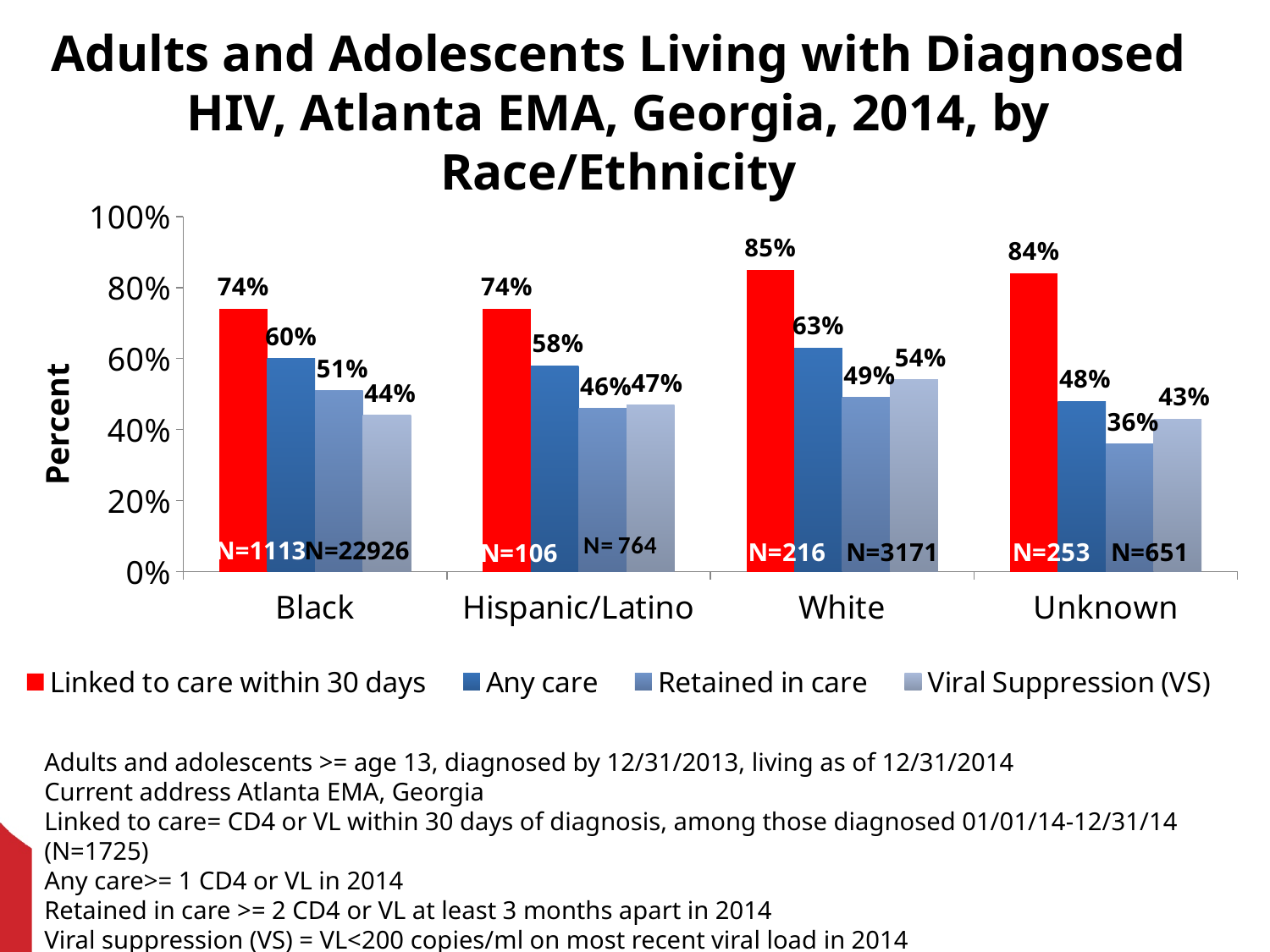
What is the value for Retained in care for Hispanic/Latino? 46% How many series does the legend list? 4 What is the value for Any care for Black? 60% What is the value for Viral Suppression (VS) for Unknown? 43% What is the value for Linked to care within 30 days for White? 85% Which race/ethnicity category has the lowest value for Retained in care? Unknown Is the Viral Suppression (VS) value larger for White or for Black? White How many race/ethnicity categories are shown on the x axis? 4 What is the label of the y axis? Percent What kind of chart is shown on the slide? Bar chart Which race/ethnicity category has the highest value for Linked to care within 30 days? White What is the difference between the Any care value for White and the Any care value for Unknown? 15%